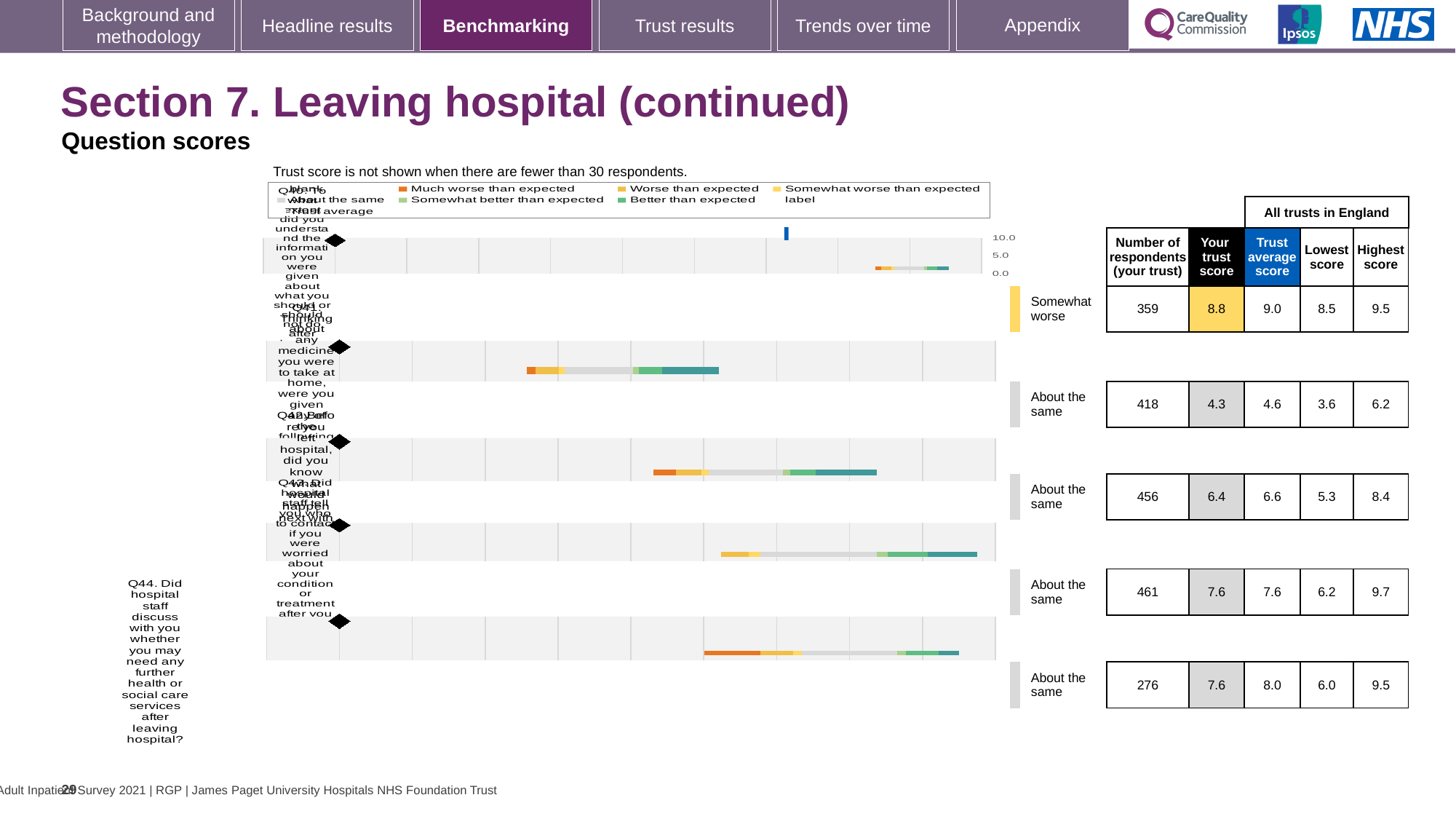
What is the trust average score for Q44? 8.0 For the top row of the chart, which is larger: your trust score (8.8) or the trust average score (9.0)? Trust average score What kind of chart is used to show the question scores? Bar chart What is the lowest score across all trusts in England for Q44? 6.0 Which row of the chart is rated 'Somewhat worse' than expected? The top (first) row What is the highest score across all trusts in England for Q44? 9.5 What is the 'Your trust score' for Q44 (Did hospital staff discuss with you whether you may need any further health or social care services after leaving hospital?)? 7.6 How many question rows are shown in the chart? 5 Which row of the chart has the lowest 'Your trust score'? The second row (4.3) Which row of the chart has the highest number of respondents? The fourth row (461 respondents) How many respondents from your trust answered Q44? 276 What is the difference between the trust average score and your trust score for Q44? 0.4